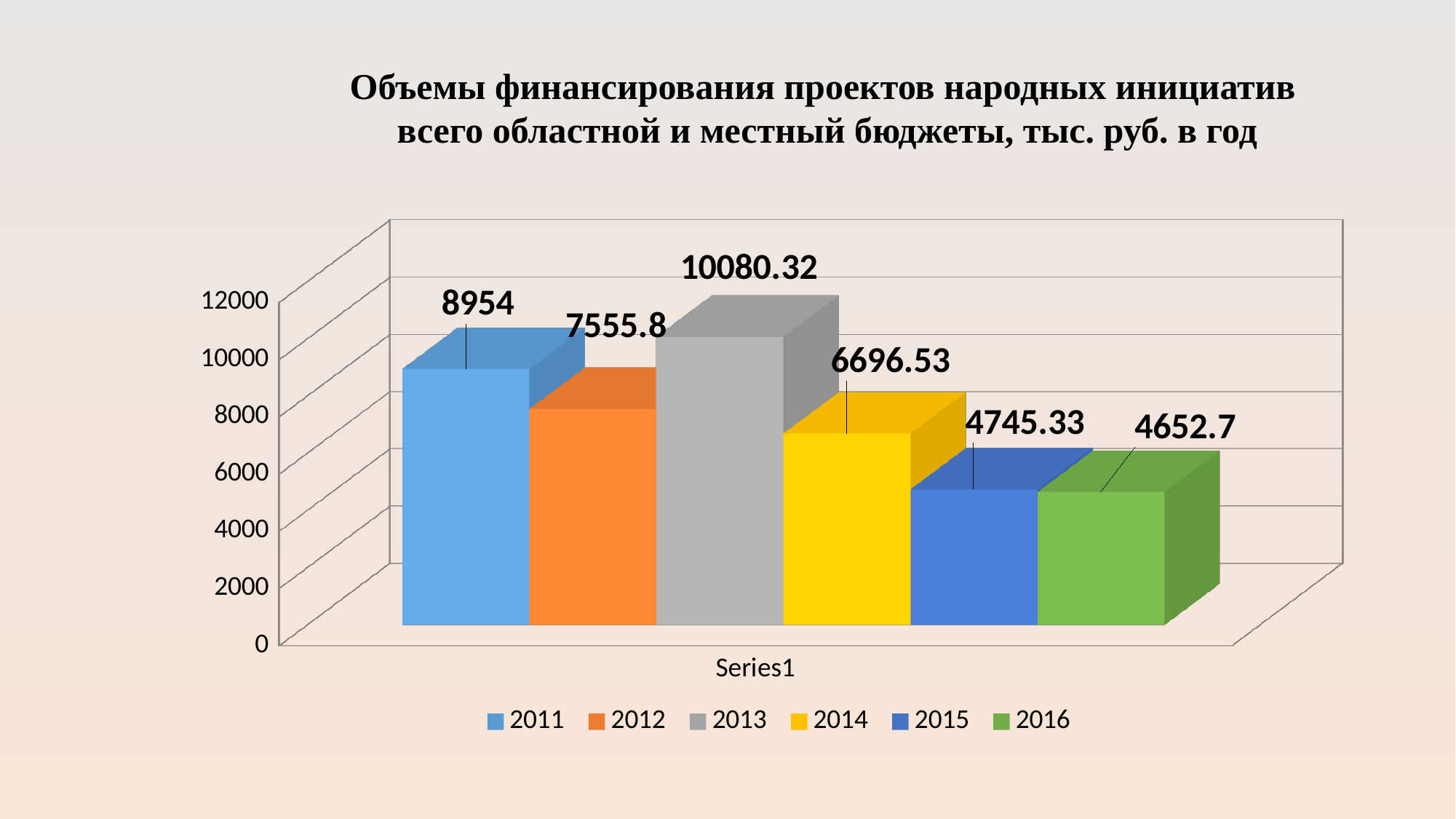
What colour is the bar for 2014? yellow What is the value for 2016? 4652.7 How many series does the legend list? 6 What kind of chart is shown on the slide? bar chart Which year has the lowest value? 2016 Which is larger, the value for 2015 or the value for 2016? 2015 What is the difference between the values for 2013 and 2014? 3383.79 What is the value for 2014? 6696.53 Which year has the highest value? 2013 What is the value for 2011? 8954 What is the difference between the values for 2011 and 2012? 1398.2 What is the value for 2013? 10080.32